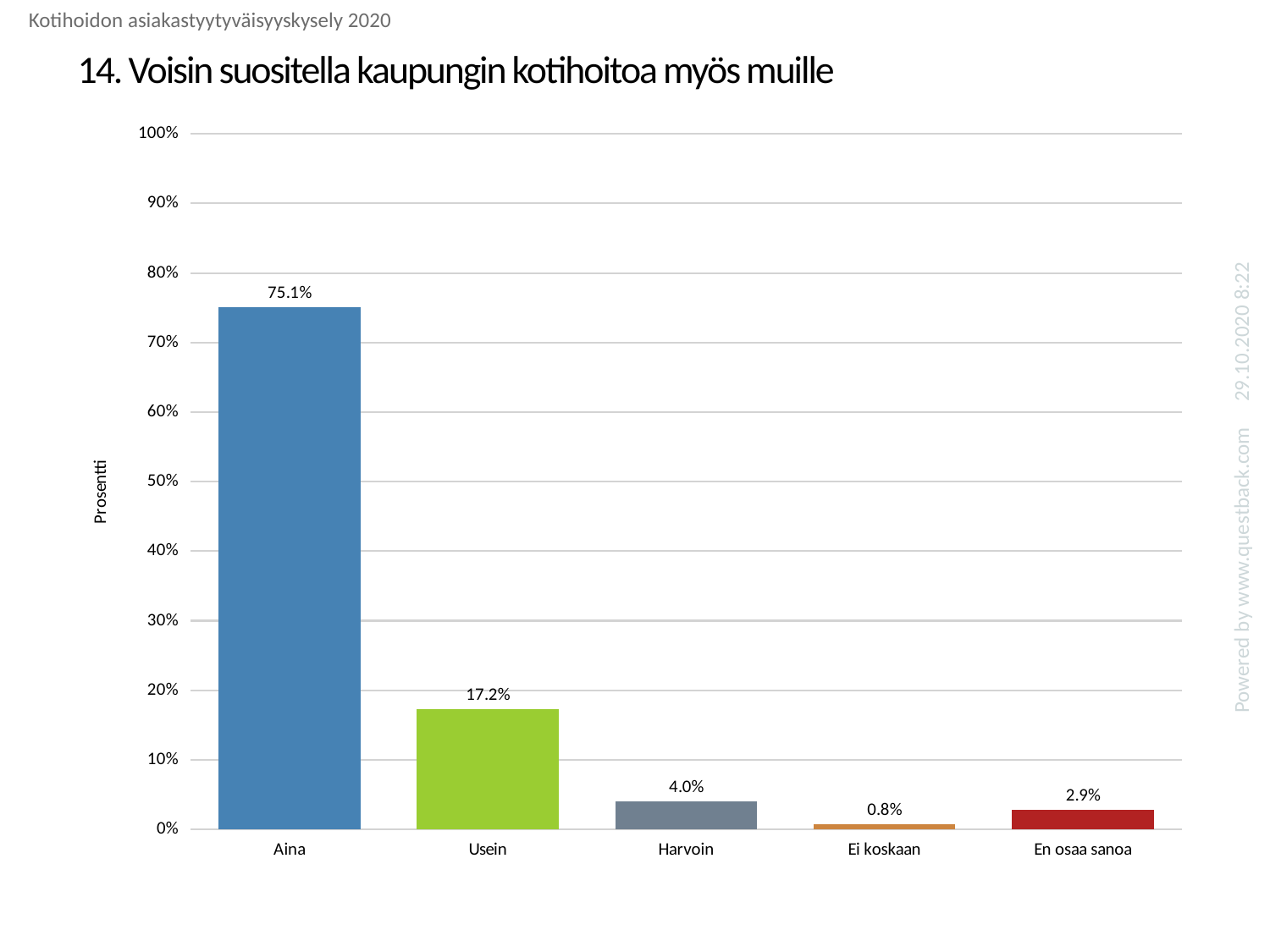
What kind of chart is shown on the slide? Bar chart Which category has the lowest value? Ei koskaan What is the value for Ei koskaan? 0.8% Which category has the highest value? Aina How many categories are shown on the x axis? 5 What is the value for Aina? 75.1% What is the label of the y axis? Prosentti What is the value for En osaa sanoa? 2.9% What is the value for Harvoin? 4.0% Which is larger, the value for Harvoin or the value for En osaa sanoa? Harvoin What is the value for Usein? 17.2% What is the difference between the values for Aina and Usein? 57.9%